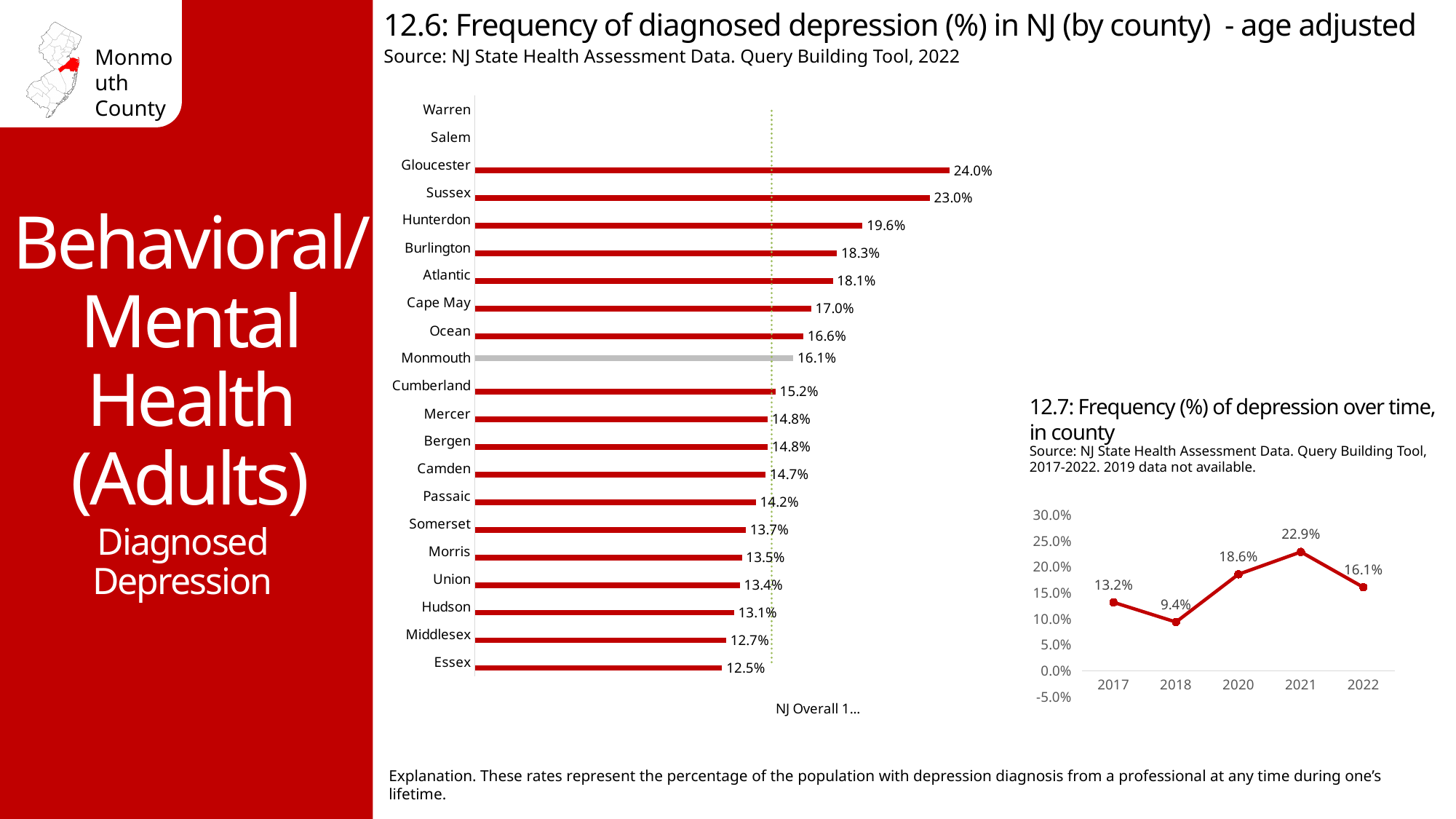
In chart 12.7, which year has the lowest frequency of depression? 2018 What kind of chart is chart 12.7? Line chart In chart 12.6, what is the difference between the values for Gloucester and Sussex? 1.0% In chart 12.6, which county has a higher value, Hunterdon or Burlington? Hunterdon In chart 12.7, what is the frequency of depression in 2021? 22.9% In chart 12.6, which county has the highest frequency of diagnosed depression? Gloucester In chart 12.7, how many years are plotted? 5 In chart 12.6, what is the value for Cape May? 17.0% In chart 12.6, what is the frequency of diagnosed depression for Monmouth County? 16.1% In chart 12.6, which county with a plotted bar has the lowest frequency of diagnosed depression? Essex In chart 12.7, what is the difference between the 2021 and 2022 values? 6.8% What kind of chart is chart 12.6? Bar chart